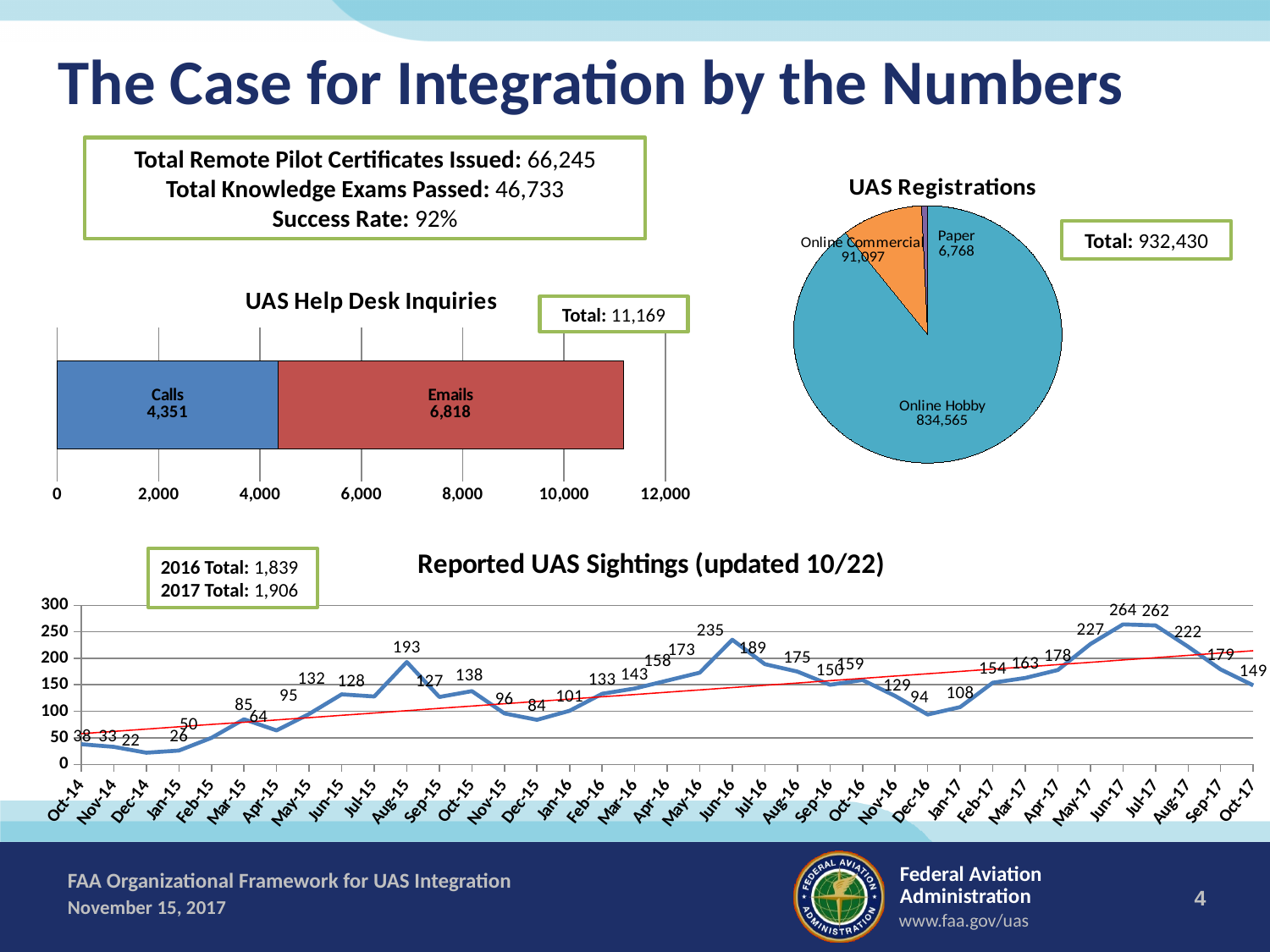
In the Reported UAS Sightings chart, what is the value for Jun-17? 264 In the Reported UAS Sightings chart, what is the difference between the values for Jun-16 and Jun-15? 103 In the UAS Registrations pie chart, what is the value for Online Commercial? 91,097 What is the total shown for the UAS Registrations pie chart? 932,430 In the UAS Help Desk Inquiries chart, how many more Emails than Calls were there? 2,467 In the UAS Registrations pie chart, which category has the smallest slice? Paper In the Reported UAS Sightings chart, which month has the highest value? Jun-17 What kind of chart is the Reported UAS Sightings chart? Line chart In the Reported UAS Sightings chart, which is larger, the value for Aug-15 or the value for Jun-16? Jun-16 In the UAS Help Desk Inquiries chart, how many Emails are shown? 6,818 What kind of chart is the UAS Help Desk Inquiries chart? Bar chart In the Reported UAS Sightings chart, which month has the lowest value? Dec-14